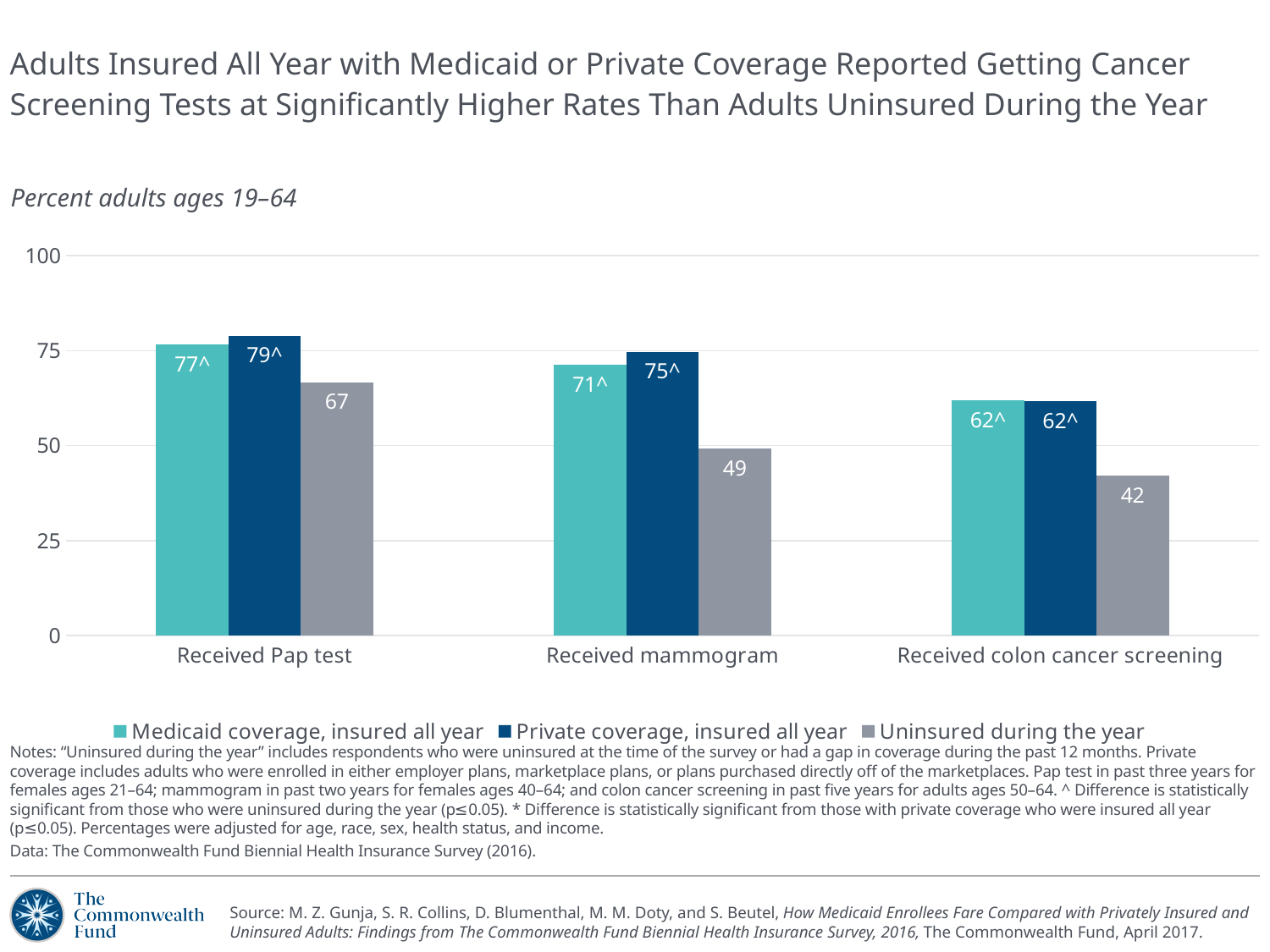
What is the subtitle describing the measure plotted on the chart? Percent adults ages 19–64 Which coverage group has the highest value for Received mammogram? Private coverage, insured all year Is the value for Uninsured during the year for Received colon cancer screening greater or less than 50? less Which is larger for Received Pap test: the Medicaid coverage value or the Uninsured during the year value? Medicaid coverage, insured all year What is the value for Uninsured during the year for Received mammogram? 49 What is the difference between the Private coverage and Uninsured values for Received mammogram? 26 Which coverage group has the lowest value for Received colon cancer screening? Uninsured during the year What kind of chart is shown on the slide? bar chart How many screening test categories are shown on the x axis? 3 How many series does the legend list? 3 What is the value for Medicaid coverage, insured all year, for Received Pap test? 77 What is the value for Private coverage, insured all year, for Received colon cancer screening? 62